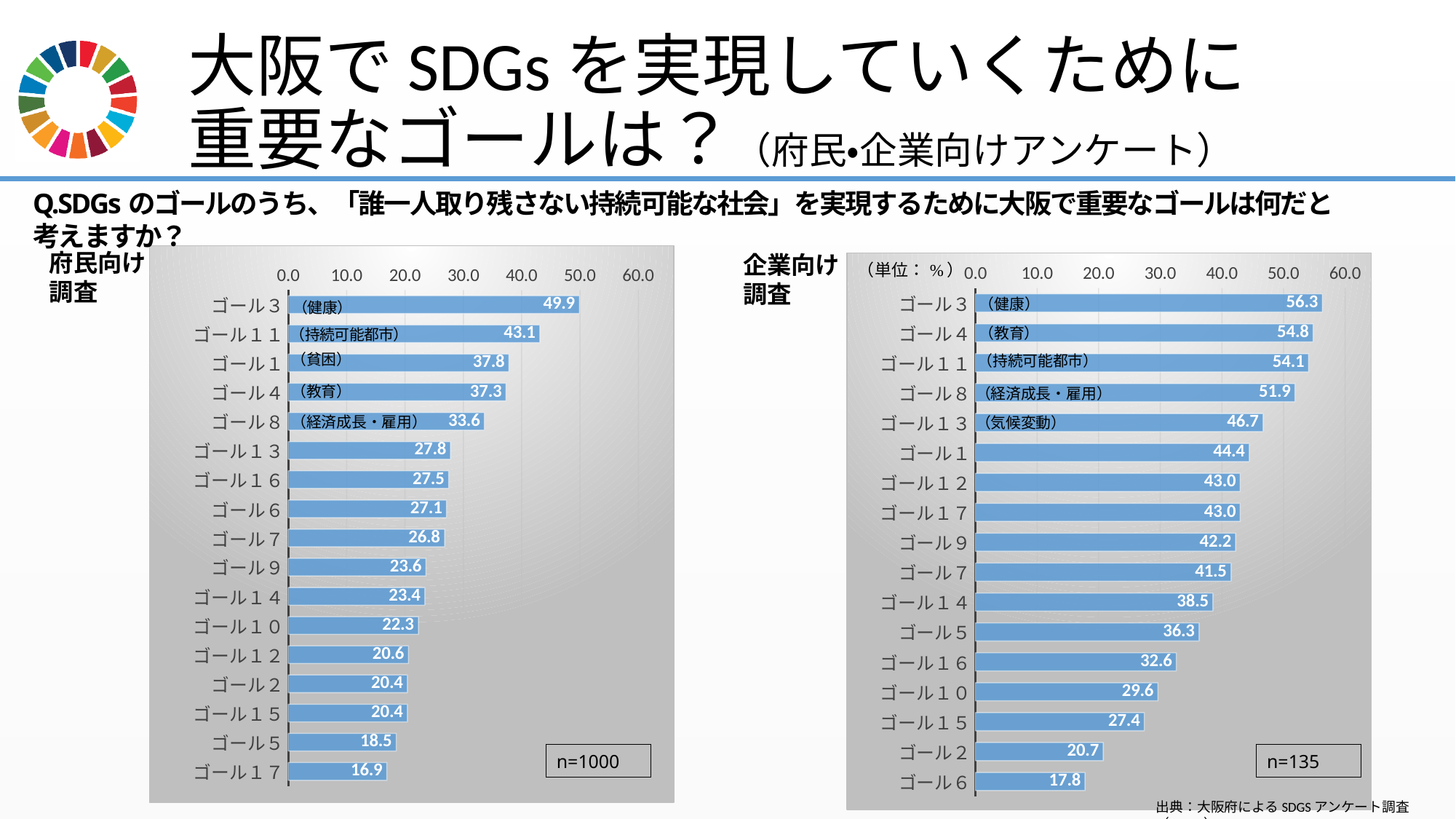
In the 府民向け調査 chart (left), which goal has the lowest value? ゴール１７ In the 府民向け調査 chart (left), which is larger, the value for ゴール１ or the value for ゴール８? ゴール１ In the 企業向け調査 chart (right), what is the value for ゴール８? 51.9 How many goals are listed in the 府民向け調査 chart (left)? 17 In the 府民向け調査 chart (left), what is the value for ゴール３? 49.9 What kind of chart is the 企業向け調査 chart (right)? bar chart What is the sample size (n) shown on the 府民向け調査 chart (left)? n=1000 In the 企業向け調査 chart (right), which goal has the lowest value? ゴール６ In the 企業向け調査 chart (right), is the value for ゴール１３ greater or less than 40.0? greater In the 企業向け調査 chart (right), which goal has the highest value? ゴール３ In the 企業向け調査 chart (right), what is the difference between the values for ゴール４ and ゴール２? 34.1 In the 府民向け調査 chart (left), what is the difference between the values for ゴール３ and ゴール１１? 6.8